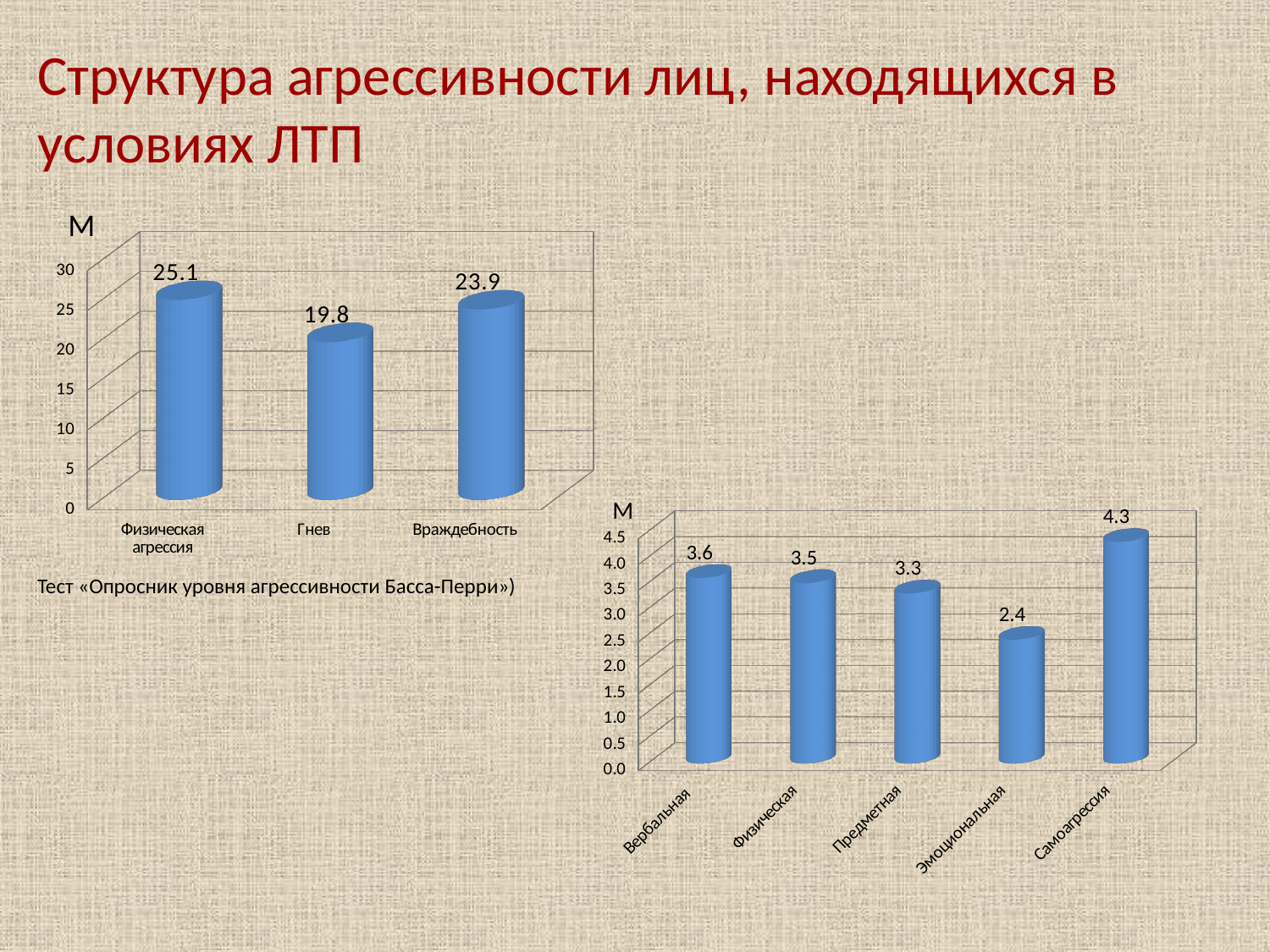
In the bottom-right chart, what is the value for Эмоциональная? 2.4 In the top-left chart, which category has the highest value? Физическая агрессия In the bottom-right chart, what is the value for Самоагрессия? 4.3 In the bottom-right chart, which is larger: Вербальная or Предметная? Вербальная In the bottom-right chart, what is the difference between Самоагрессия and Эмоциональная? 1.9 What type of chart is the bottom-right chart? Bar chart In the top-left chart, what is the value for Гнев? 19.8 In the top-left chart, what is the value for Враждебность? 23.9 In the top-left chart, how many categories are shown? 3 In the top-left chart, what is the difference between Физическая агрессия and Гнев? 5.3 In the bottom-right chart, which category has the lowest value? Эмоциональная In the top-left chart, which category has the lowest value? Гнев